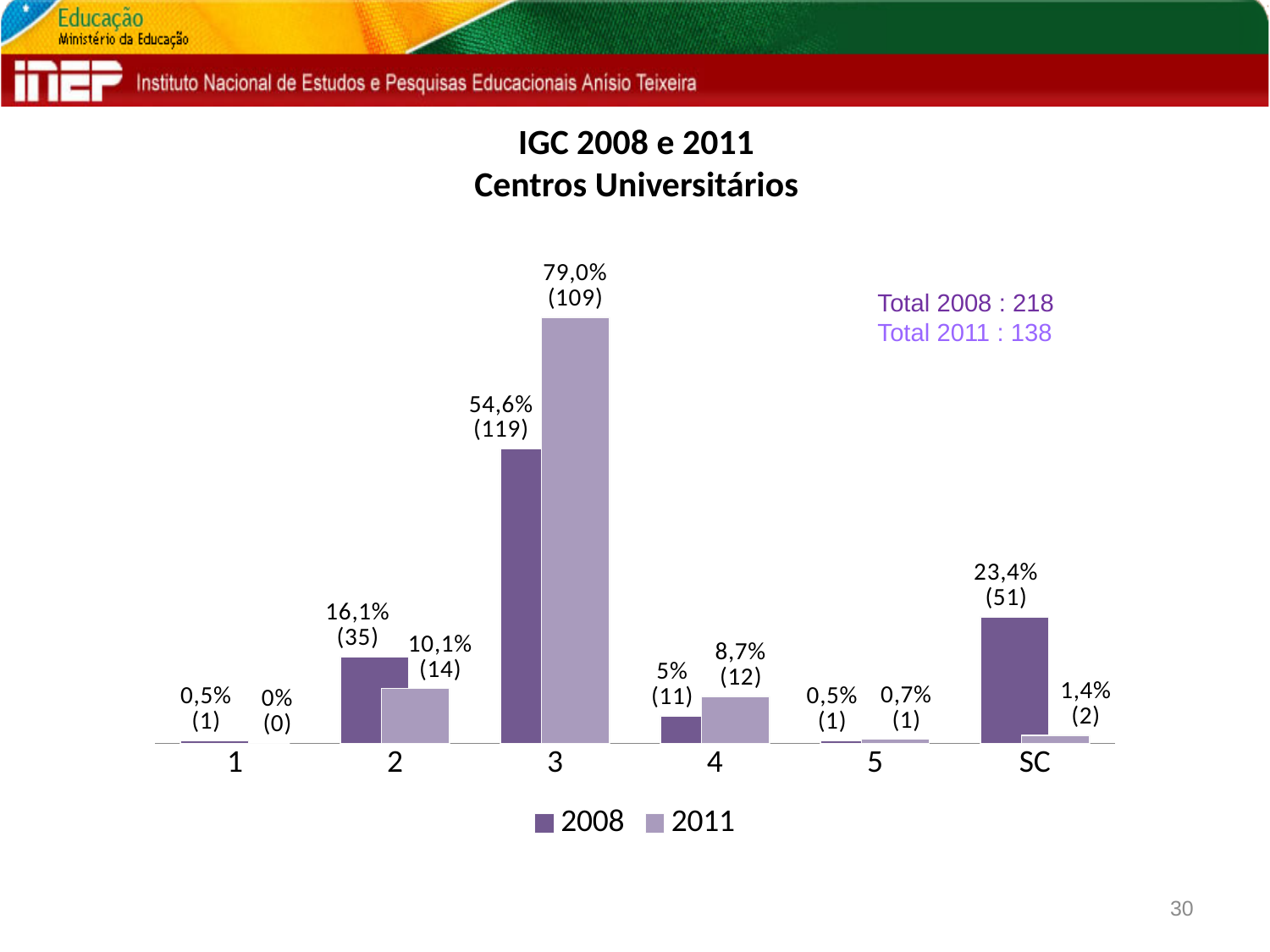
What is the 2011 value for category 3? 79,0% (109) Which category has the highest 2011 value? 3 Which category has the lowest 2011 value? 1 What is the total for 2011 stated on the slide? 138 What kind of chart is shown? bar chart How many series does the legend list? 2 How many categories are shown on the x axis? 6 What is the difference in percentage points between the 2011 and 2008 values for category 3? 24,4 Which is larger for category 4, the 2008 value or the 2011 value? 2011 What is the 2008 value for category SC? 23,4% (51) What is the 2011 value for category 2? 10,1% (14) What is the 2008 value for category 3? 54,6% (119)